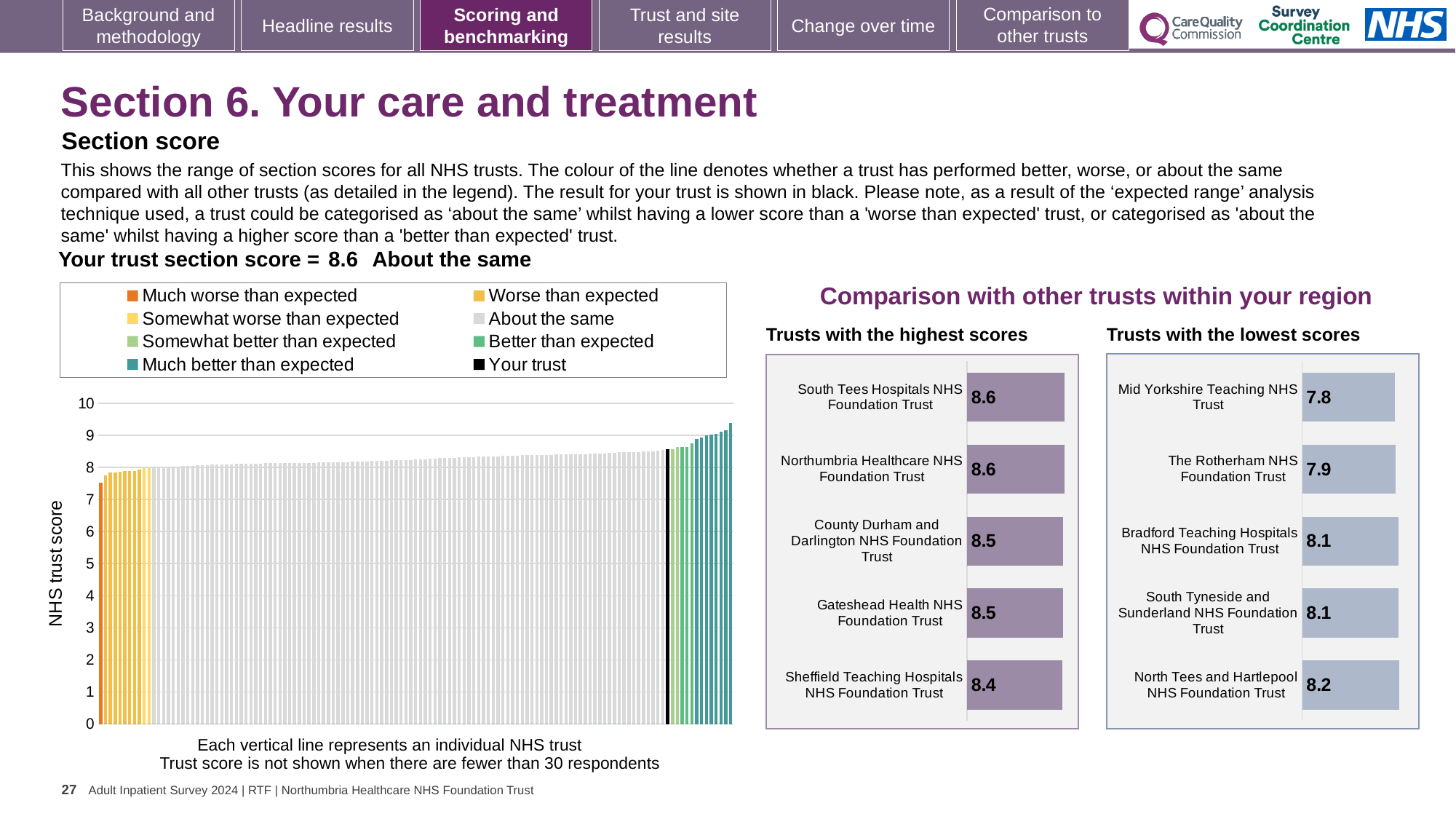
In the 'Trusts with the highest scores' chart, which trust has the lowest score shown? Sheffield Teaching Hospitals NHS Foundation Trust In the main 'NHS trust score' chart on the left, is the value of the lowest-scoring trust greater or less than 7? greater In the main 'NHS trust score' chart on the left, do the trust scores rise or fall from left to right? rise In the 'Trusts with the highest scores' chart, which has the higher score: Gateshead Health NHS Foundation Trust or Sheffield Teaching Hospitals NHS Foundation Trust? Gateshead Health NHS Foundation Trust In the 'Trusts with the lowest scores' chart, what is the difference between the scores of North Tees and Hartlepool NHS Foundation Trust and Mid Yorkshire Teaching NHS Trust? 0.4 In the 'Trusts with the lowest scores' chart, which trust has the highest score shown? North Tees and Hartlepool NHS Foundation Trust How many trusts are listed in the 'Trusts with the highest scores' chart? 5 In the 'Trusts with the highest scores' chart, what is the score for Gateshead Health NHS Foundation Trust? 8.5 In the main 'NHS trust score' chart on the left, what is the section score for your trust? 8.6 How many entries does the legend of the main 'NHS trust score' chart list? 8 In the 'Trusts with the lowest scores' chart, which trust has the lowest score? Mid Yorkshire Teaching NHS Trust In the 'Trusts with the lowest scores' chart, what is the score for Bradford Teaching Hospitals NHS Foundation Trust? 8.1